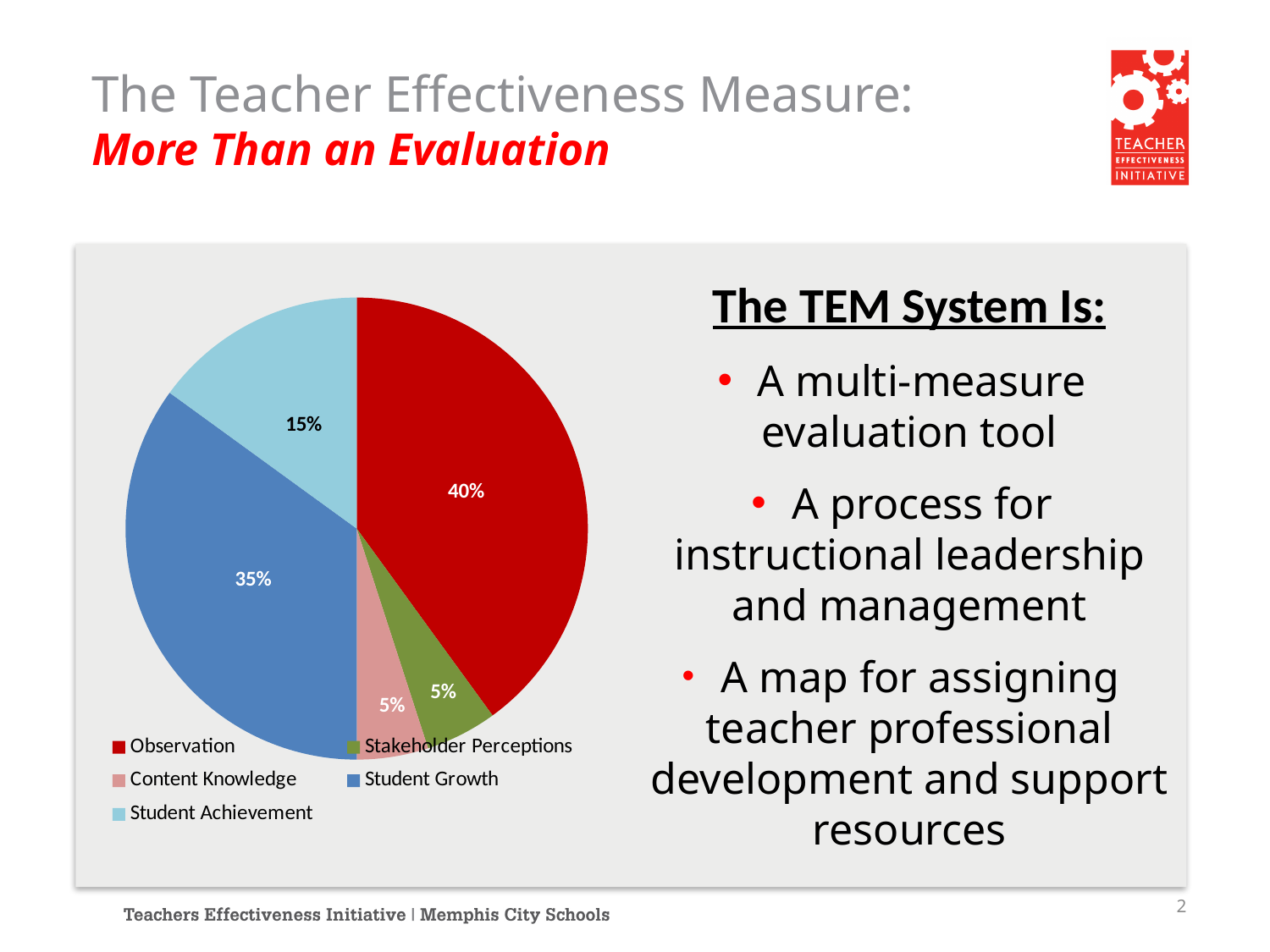
Which is larger, the share for Student Growth or the share for Student Achievement? Student Growth What type of chart is shown on the slide? pie chart What is the combined share of Student Growth and Student Achievement? 50% What percentage of the pie chart is Student Growth? 35% What percentage of the pie chart is Content Knowledge? 5% How many categories does the pie chart show? 5 What is the difference between the Observation share and the Student Growth share? 5% What percentage of the pie chart is Student Achievement? 15% What percentage of the pie chart is Stakeholder Perceptions? 5% Which category has the largest share of the pie chart? Observation What percentage of the pie chart is Observation? 40% What colour is the Observation slice in the pie chart? red